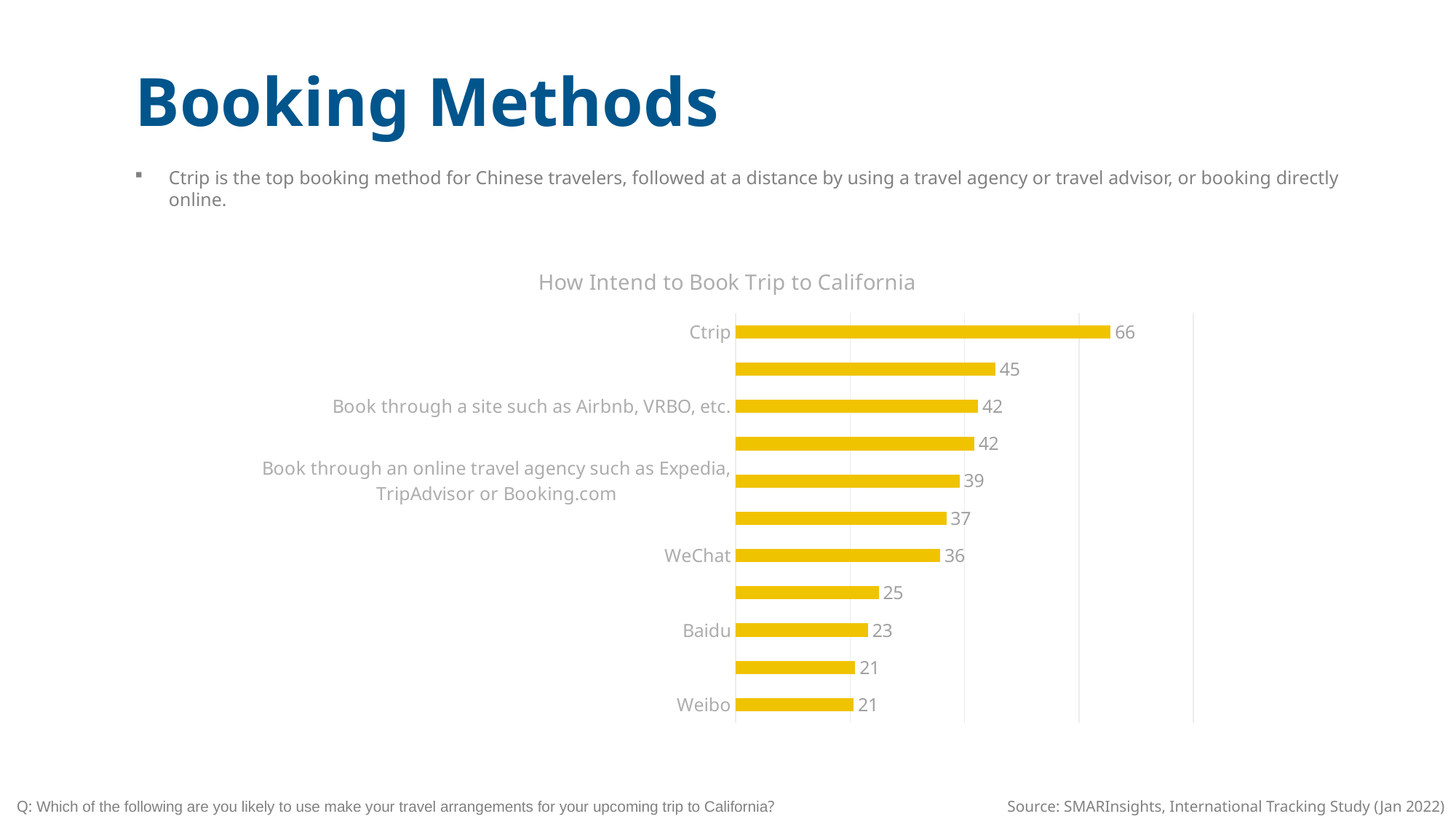
What is the value for WeChat? 36 What type of chart is shown on the slide? Bar chart What is the value for Ctrip in the chart? 66 What is the difference between the values for Baidu and Weibo? 2 What is the value for Weibo? 21 How many bars are plotted in the chart? 11 What is the value for 'Book through a site such as Airbnb, VRBO, etc.'? 42 Which has a larger value, WeChat or Baidu? WeChat What is the value for Baidu? 23 What is the difference between the values for Ctrip and WeChat? 30 Which booking method has the highest value in the chart? Ctrip What is the title of the chart? How Intend to Book Trip to California